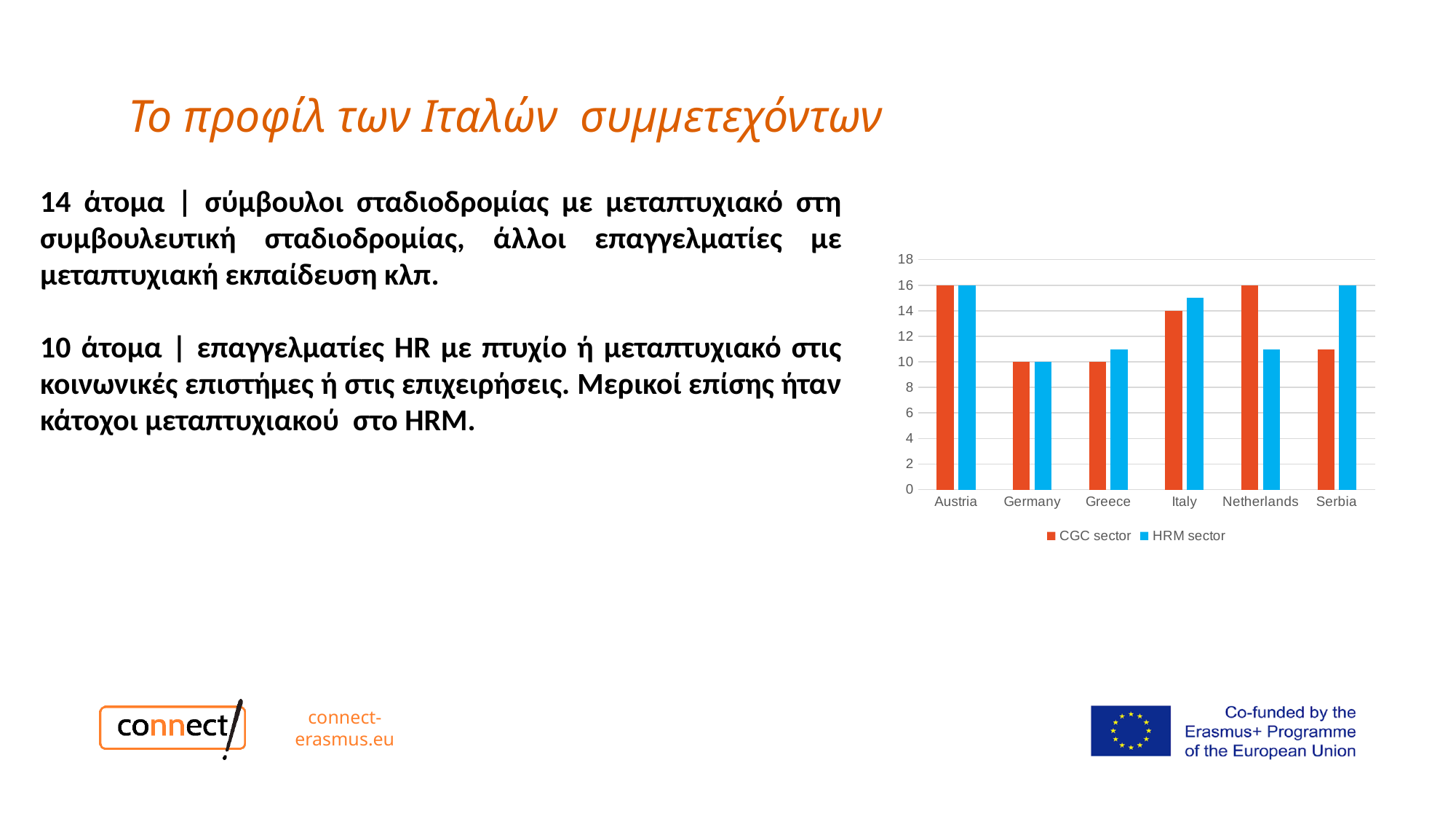
Which is larger for Netherlands, the CGC sector value or the HRM sector value? CGC sector Is the HRM sector value for Italy greater or less than 14? greater What is the CGC sector value for Austria? 16 What is the difference between the CGC sector values for Netherlands and Germany? 6 What is the HRM sector value for Germany? 10 What is the HRM sector value for Serbia? 16 How many countries are shown on the x axis of the chart? 6 How many series does the chart legend list? 2 What is the CGC sector value for Italy? 14 Is the HRM sector value for Netherlands greater or less than 12? less Which series is shown in blue in the chart? HRM sector What type of chart is shown on the slide? bar chart